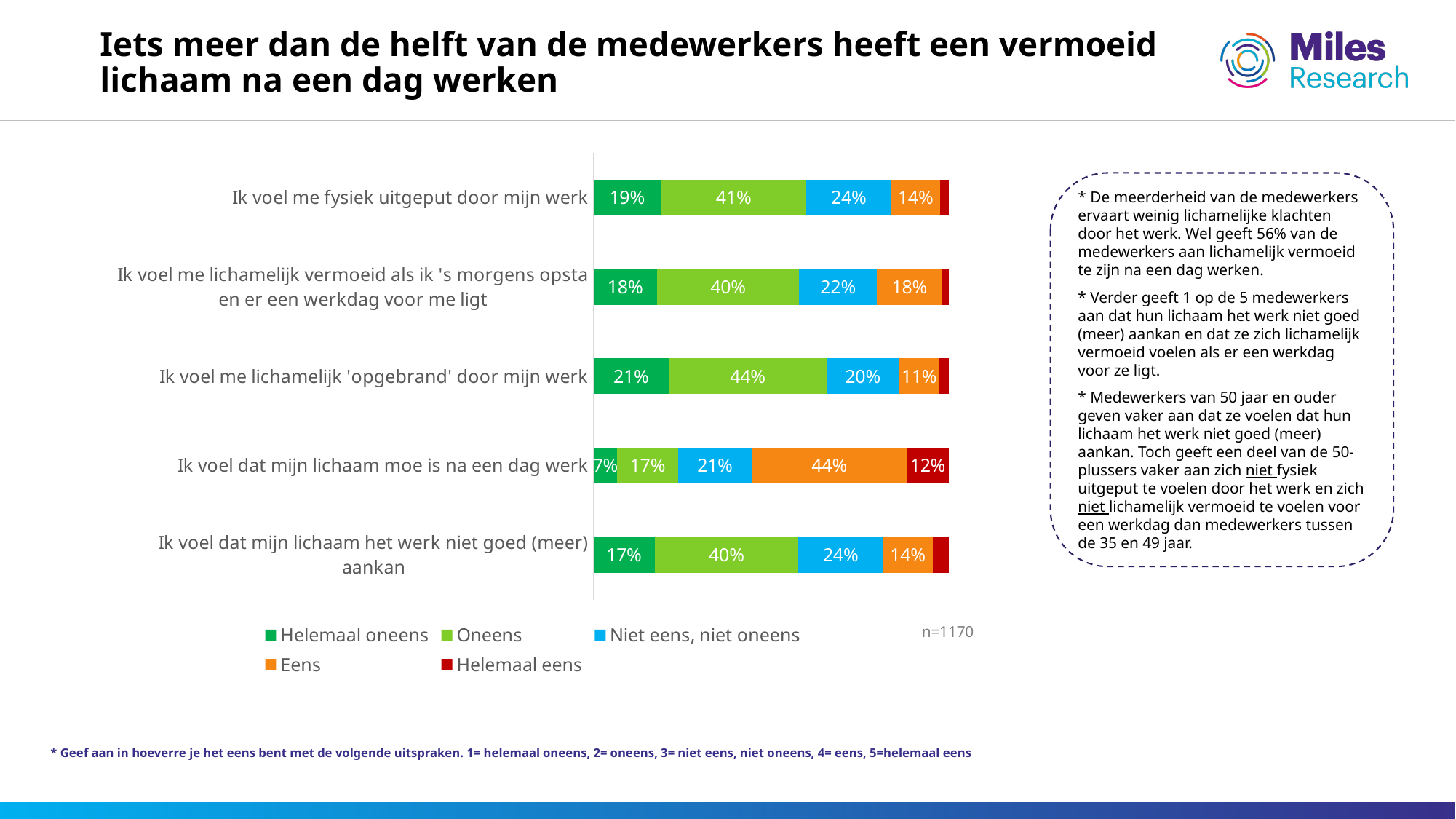
What is the 'Niet eens, niet oneens' share for 'Ik voel me fysiek uitgeput door mijn werk'? 24% What percentage answered 'Helemaal eens' to 'Ik voel dat mijn lichaam moe is na een dag werk'? 12% Which statement has the highest 'Eens' percentage? Ik voel dat mijn lichaam moe is na een dag werk What type of chart is shown on the slide? Stacked bar chart Which has a larger 'Niet eens, niet oneens' share: 'Ik voel me fysiek uitgeput door mijn werk' or 'Ik voel me lichamelijk 'opgebrand' door mijn werk'? Ik voel me fysiek uitgeput door mijn werk What percentage of respondents answered 'Oneens' to the statement 'Ik voel me lichamelijk 'opgebrand' door mijn werk'? 44% What is the combined share of 'Eens' and 'Helemaal eens' for 'Ik voel dat mijn lichaam moe is na een dag werk'? 56% What percentage answered 'Eens' to 'Ik voel dat mijn lichaam moe is na een dag werk'? 44% Which statement has the lowest 'Eens' percentage? Ik voel me lichamelijk 'opgebrand' door mijn werk How many statements are shown in the chart? 5 How many answer categories does the legend list? 5 How many percentage points higher is the 'Eens' share for 'Ik voel dat mijn lichaam moe is na een dag werk' than for 'Ik voel me lichamelijk 'opgebrand' door mijn werk'? 33 percentage points